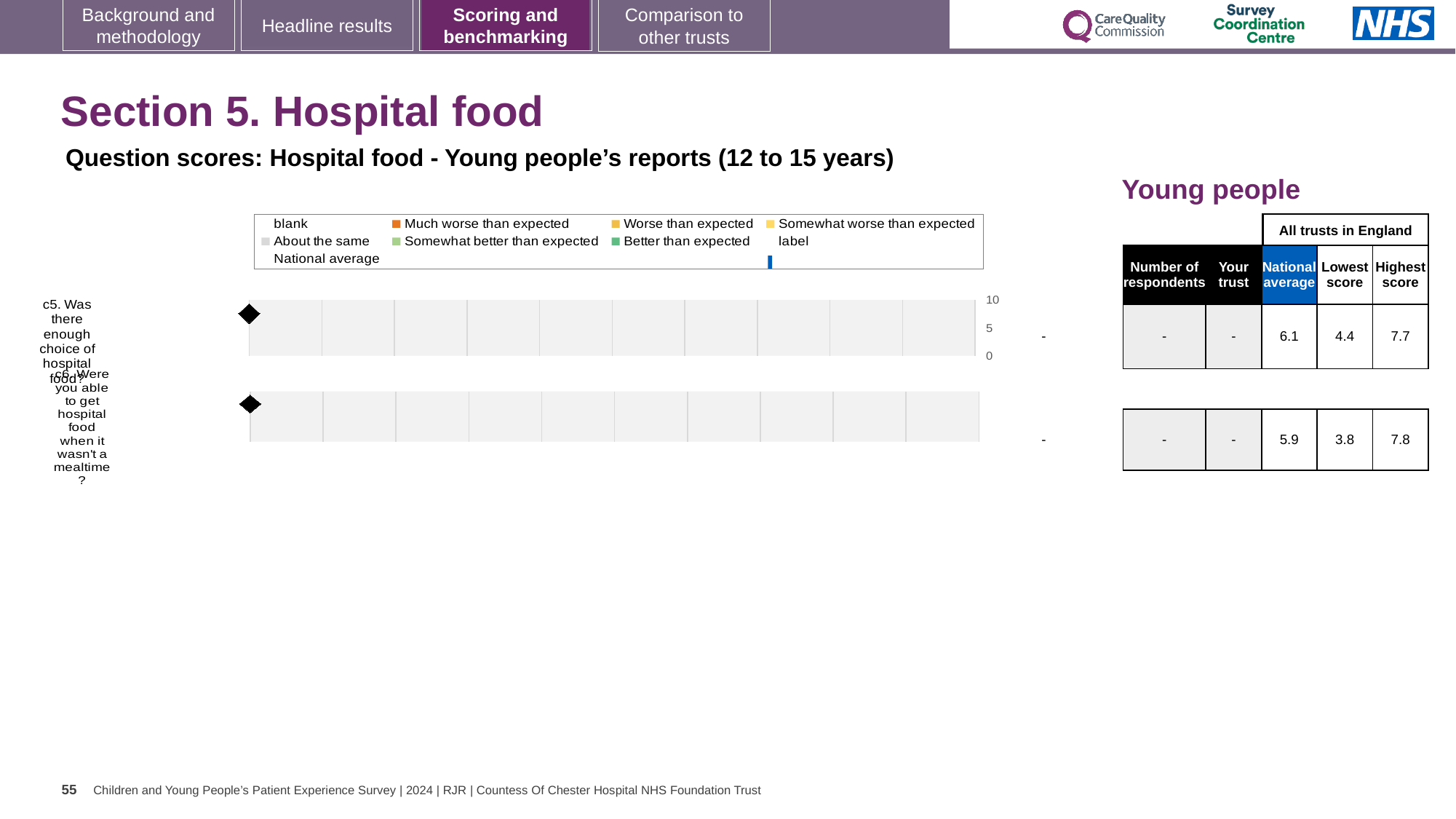
In the table beside the chart, is the national average for c6 greater or less than 5? greater In the table beside the chart, what is the national average score for c6 (Were you able to get hospital food when it wasn't a mealtime?)? 5.9 In the table beside the chart, what is the national average score for c5 (Was there enough choice of hospital food?)? 6.1 How many survey questions (categories) are plotted on the chart? 2 Which survey question is listed first on the chart? c5. Was there enough choice of hospital food? In the table beside the chart, which question has the higher national average, c5 or c6? c5 In the table beside the chart, what is the difference between the highest and lowest scores for c6? 4.0 In the table beside the chart, what is the difference between the highest and lowest scores for c5? 3.3 What kind of chart is shown on the slide? bar chart In the table beside the chart, what is the highest score across all trusts in England for c6? 7.8 What is the highest value shown on the chart's axis? 10 In the table beside the chart, what is the lowest score across all trusts in England for c5? 4.4